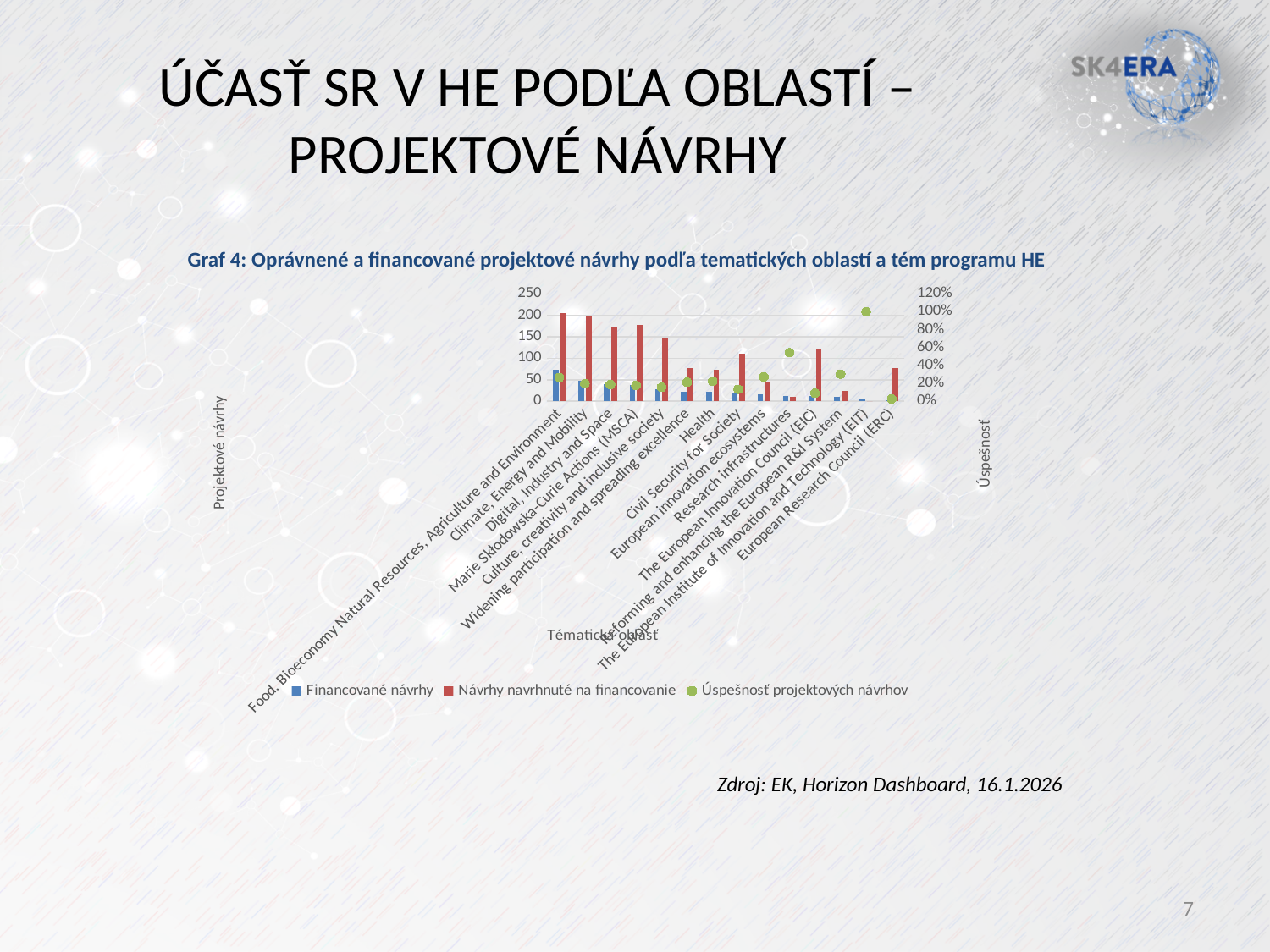
Which has more 'Návrhy navrhnuté na financovanie': Food, Bioeconomy Natural Resources, Agriculture and Environment or Health? Food, Bioeconomy Natural Resources, Agriculture and Environment Is the value of 'Financované návrhy' for Food, Bioeconomy Natural Resources, Agriculture and Environment greater or less than 50? greater What is the title of the chart? Graf 4: Oprávnené a financované projektové návrhy podľa tematických oblastí a tém programu HE Which thematic area has the highest 'Úspešnosť projektových návrhov'? The European Institute of Innovation and Technology (EIT) Is the value of 'Návrhy navrhnuté na financovanie' for The European Institute of Innovation and Technology (EIT) greater or less than 50? less How many series does the legend list? 3 Is the value of 'Návrhy navrhnuté na financovanie' for Health greater or less than 100? less Which series is plotted with green markers? Úspešnosť projektových návrhov How many thematic areas (categories) are shown on the x axis? 14 Which thematic area has the lowest 'Úspešnosť projektových návrhov'? European Research Council (ERC) What kind of chart is shown on the slide? bar chart with markers (combo chart)